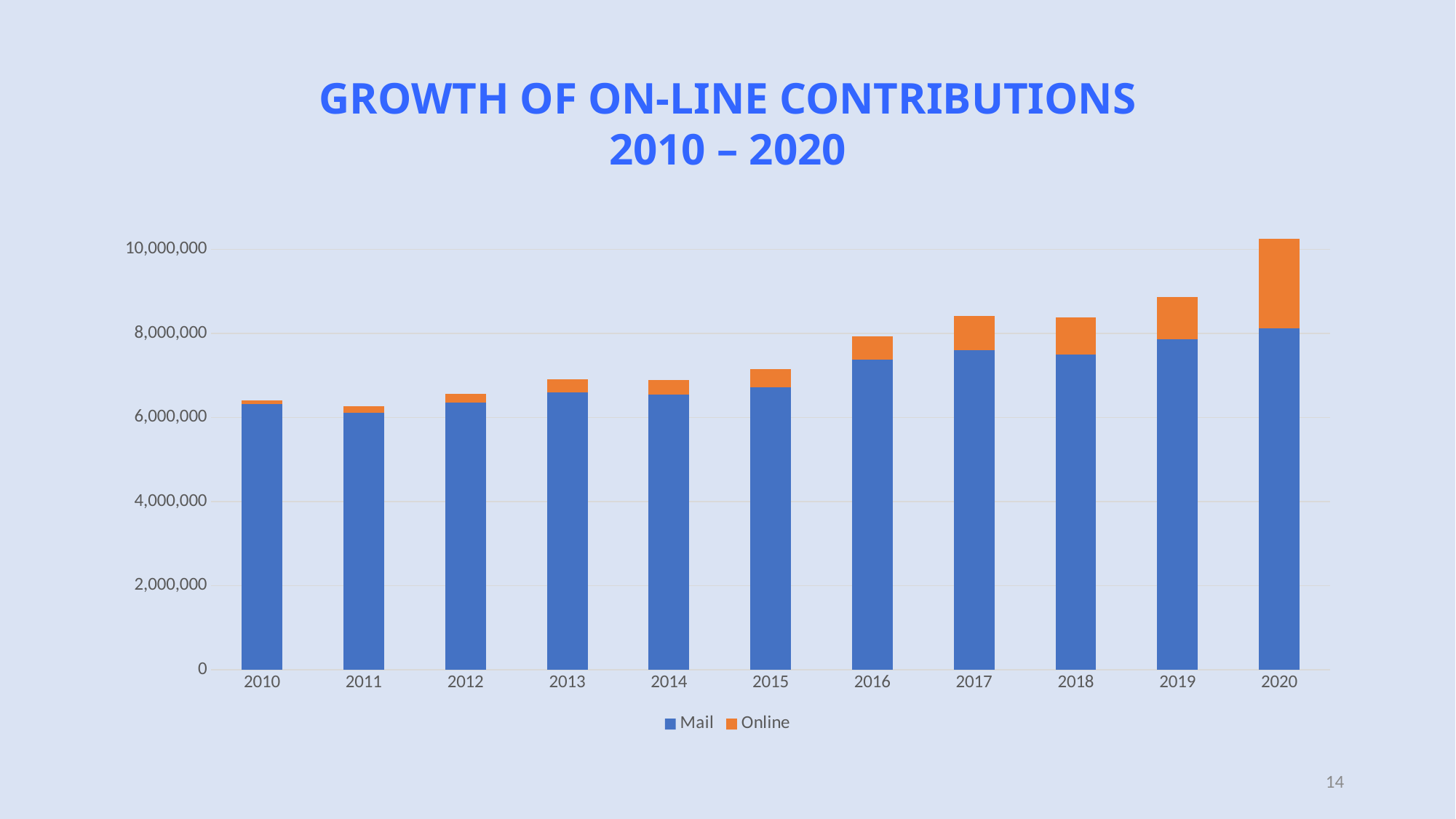
What kind of chart is shown on the slide? Stacked bar chart Is the total bar for 2011 greater or less than 6,000,000? greater Is the total bar for 2010 greater or less than 8,000,000? less Which colour represents the Online series in the chart? Orange Is the total bar for 2020 greater or less than 8,000,000? greater Which is larger, the total bar for 2020 or the total bar for 2010? 2020 Which year has the highest total contributions in the chart? 2020 Which is larger, the Online portion for 2020 or the Online portion for 2010? 2020 How many years are shown on the x axis of the chart? 11 How many series does the chart's legend list? 2 Do the total contributions generally rise or fall from 2010 to 2020? rise